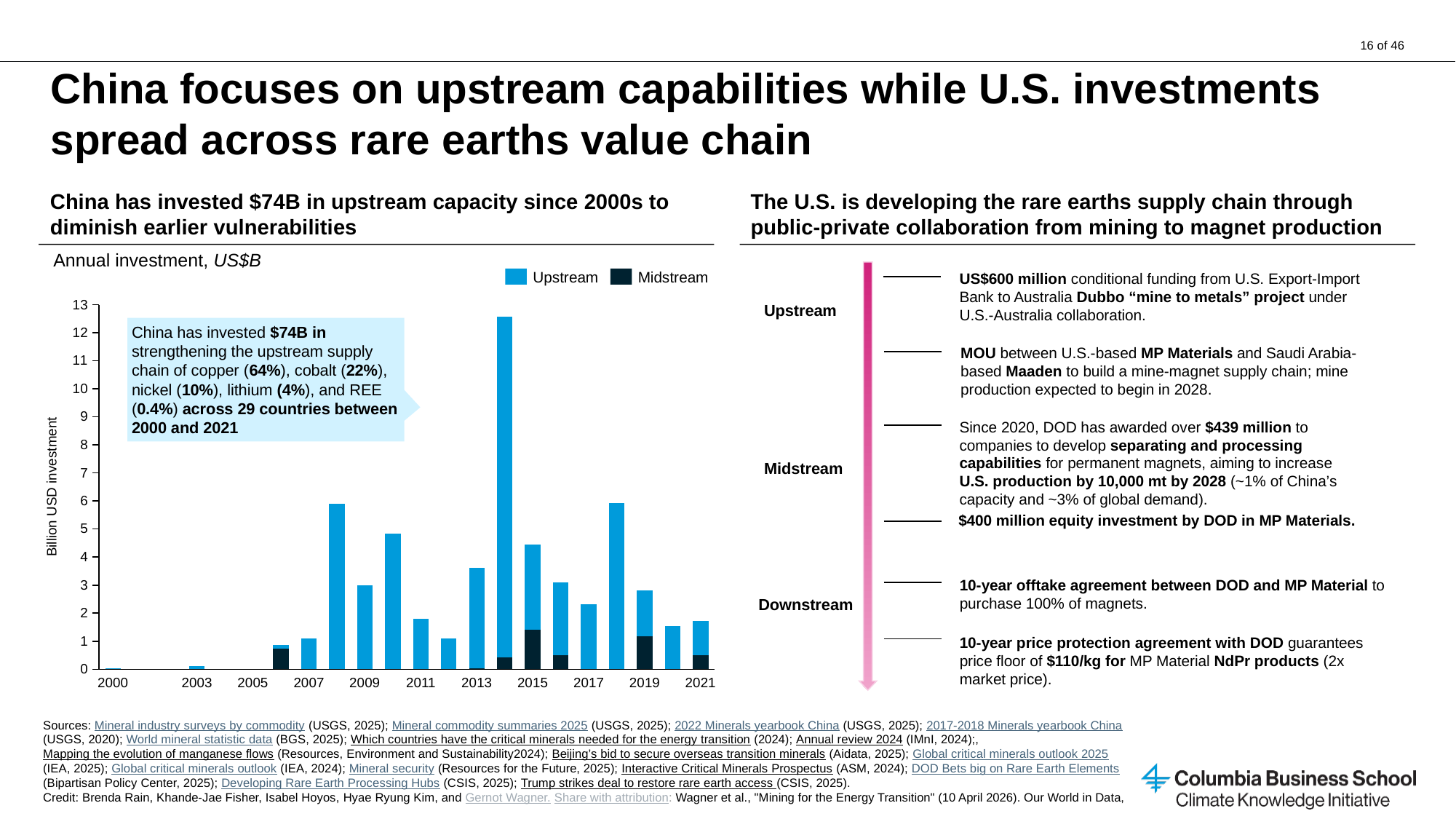
Which year has the larger total investment, 2008 or 2009? 2008 Which year has the larger total investment, 2010 or 2013? 2010 Is the total investment for 2017 greater or less than 3? less Do total investments rise or fall from 2014 to 2017? fall Is the Midstream investment for 2015 greater or less than 1? greater Is the total investment for 2014 greater or less than 10? greater Which year has the highest total annual investment in the chart? 2014 How many series does the legend of the annual investment chart list? 2 What is the label on the vertical axis of the annual investment chart? Billion USD investment What kind of chart is used to show China's annual investment? bar chart